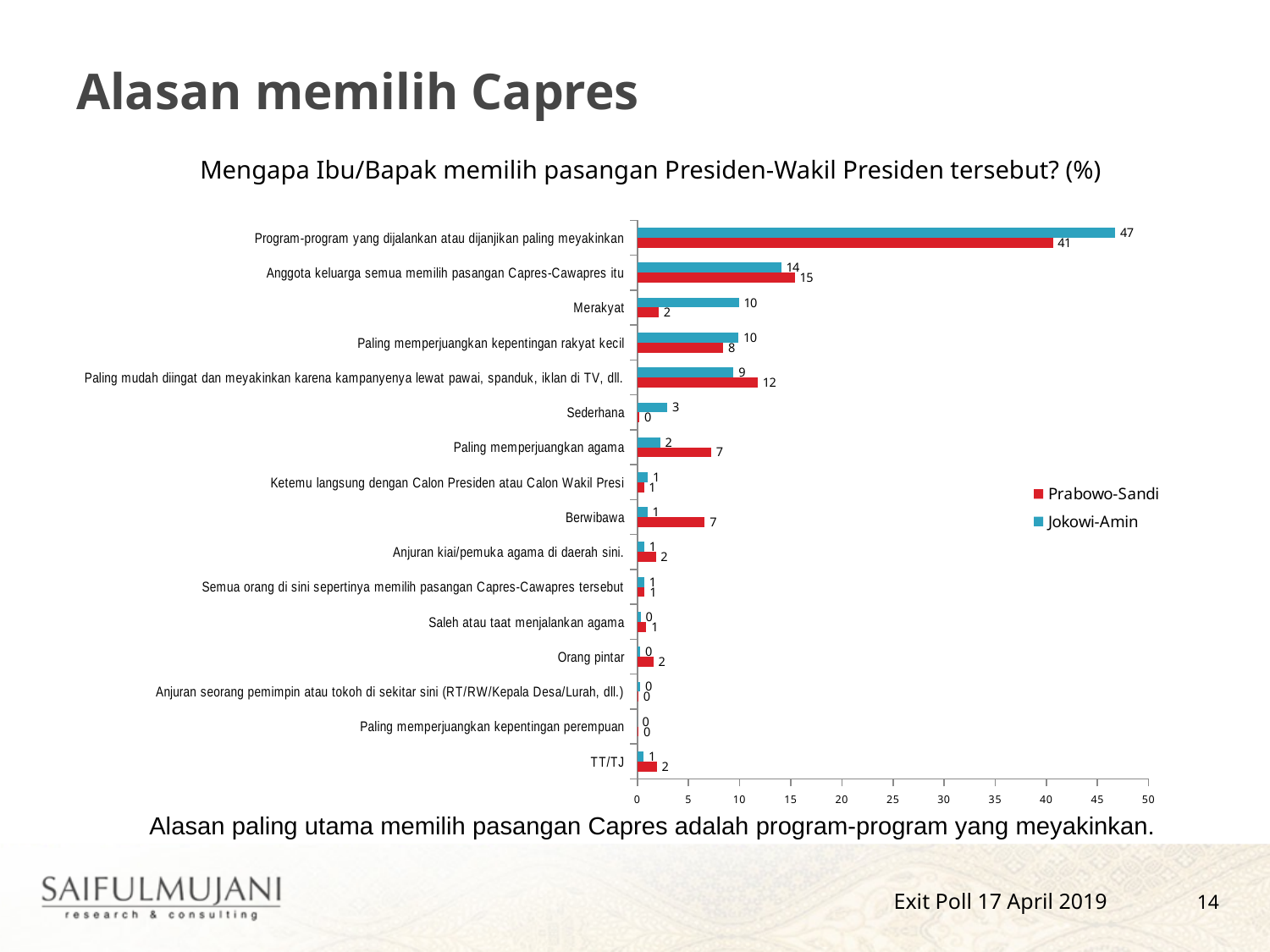
Which category has the highest Prabowo-Sandi value? Program-program yang dijalankan atau dijanjikan paling meyakinkan For "Merakyat", which series has the larger value? Jokowi-Amin How many series does the legend list? 2 What kind of chart is shown on the slide? Bar chart What is the Jokowi-Amin value for "Sederhana"? 3 What is the Prabowo-Sandi value for "Paling memperjuangkan agama"? 7 What is the difference between the Jokowi-Amin and Prabowo-Sandi values for "Program-program yang dijalankan atau dijanjikan paling meyakinkan"? 6 What is the difference between the Prabowo-Sandi and Jokowi-Amin values for "Berwibawa"? 6 What is the Prabowo-Sandi value for "Merakyat"? 2 What is the Jokowi-Amin value for "Program-program yang dijalankan atau dijanjikan paling meyakinkan"? 47 How many categories are shown on the chart? 16 For "Paling mudah diingat dan meyakinkan karena kampanyenya lewat pawai, spanduk, iklan di TV, dll.", which series has the larger value? Prabowo-Sandi